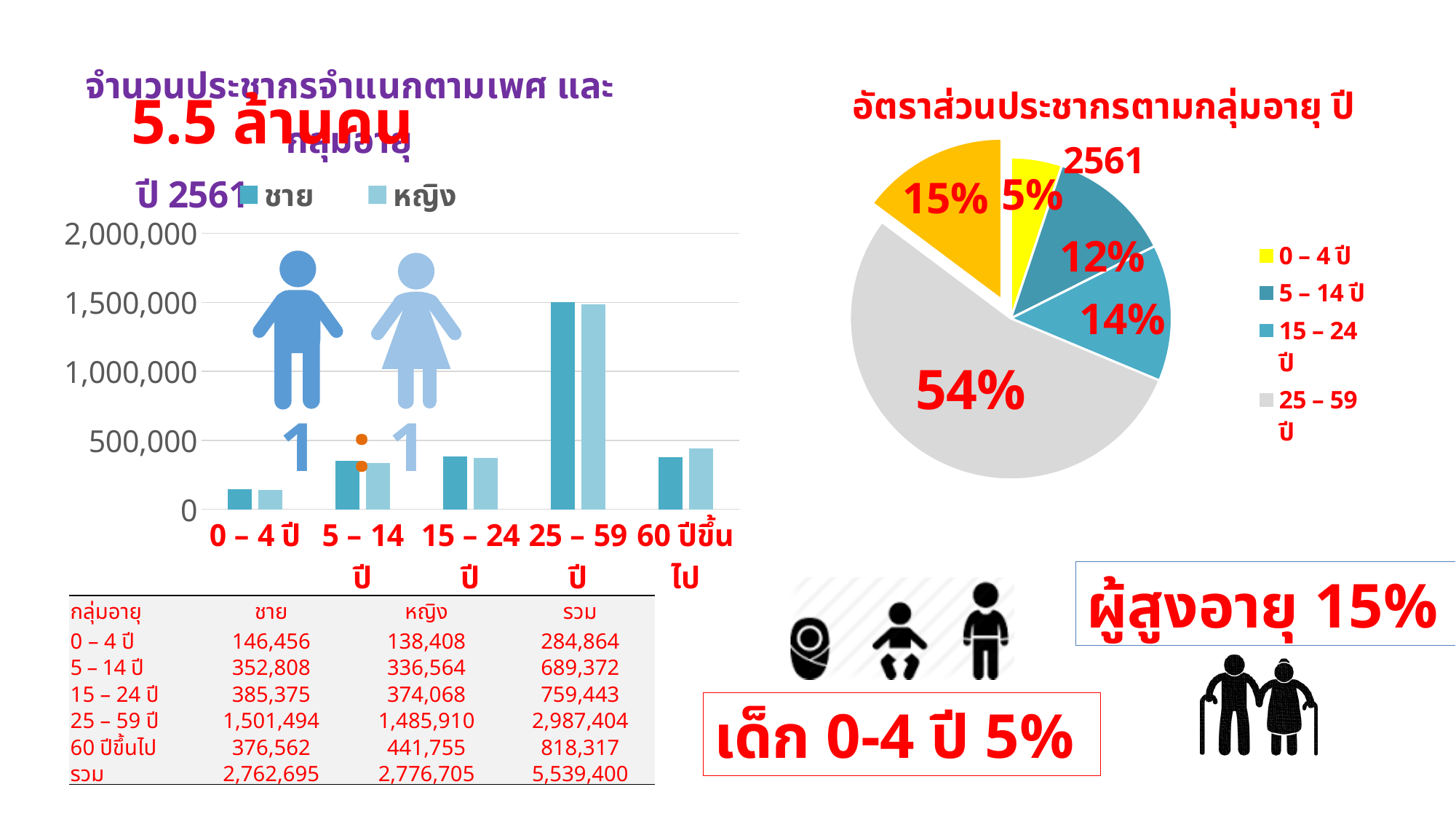
In the bar chart on the left, which age group has the highest bars? 25 – 59 ปี In the pie chart on the right, what share does the 0 – 4 ปี slice have? 5% In the pie chart on the right, what share does the 25 – 59 ปี slice have? 54% In the bar chart on the left, which age group has the lowest bars? 0 – 4 ปี In the bar chart on the left, is the value for ชาย in the 25 – 59 ปี group greater or less than 1,000,000? greater What kind of chart is the chart on the left of the slide? bar chart What kind of chart is the chart on the right of the slide? pie chart In the bar chart on the left, for the 60 ปีขึ้นไป group, which is larger, ชาย or หญิง? หญิง In the bar chart on the left, how many series does the legend list? 2 In the bar chart on the left, is the value for หญิง in the 0 – 4 ปี group greater or less than 500,000? less In the pie chart on the right, which legend entry has the largest slice? 25 – 59 ปี In the bar chart on the left, how many age-group categories are shown on the x axis? 5